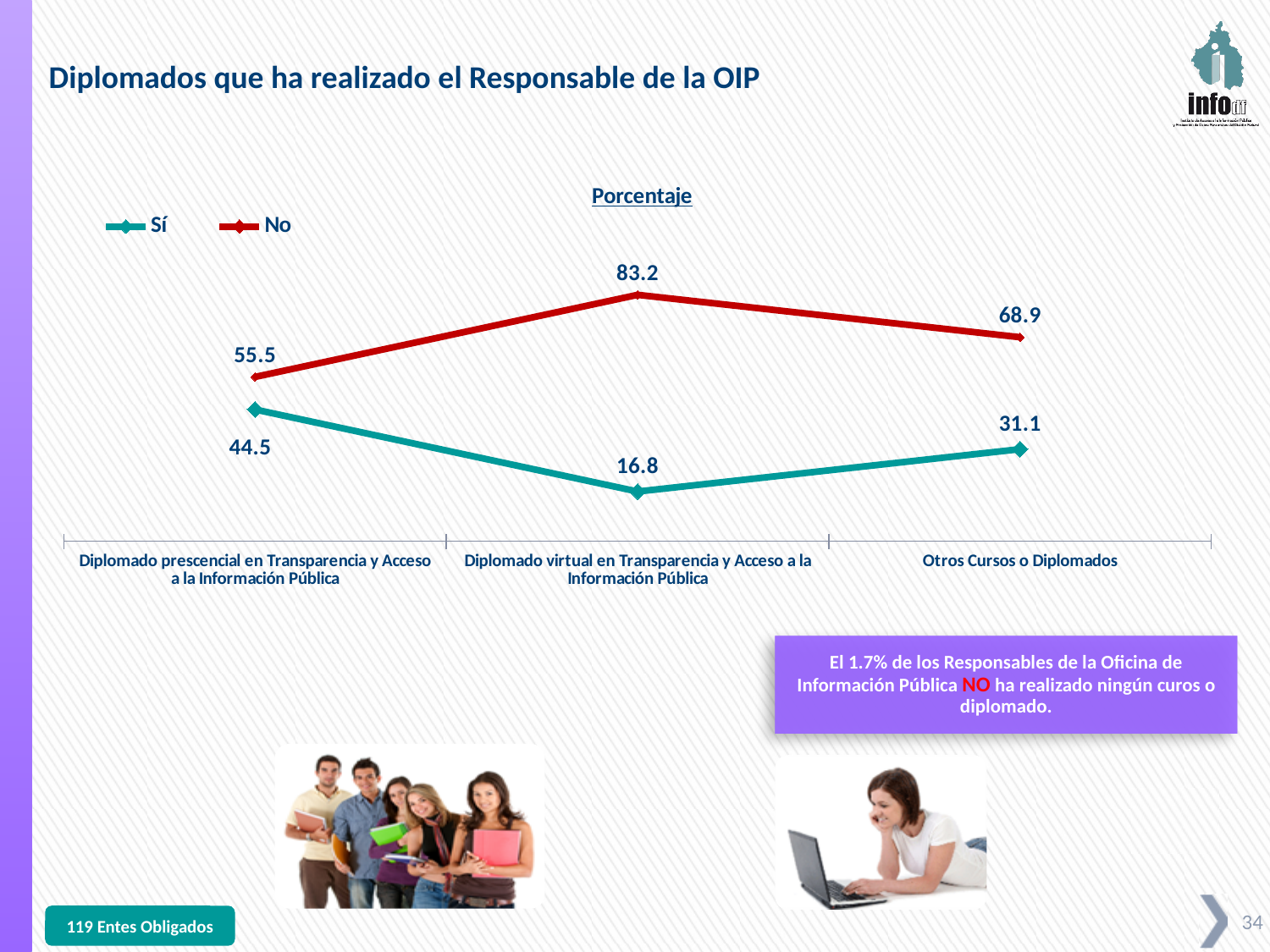
Which category has the lowest 'Sí' value? Diplomado virtual en Transparencia y Acceso a la Información Pública What is the 'Sí' value for 'Diplomado virtual en Transparencia y Acceso a la Información Pública'? 16.8 What kind of chart is shown on the slide? Line chart What is the title shown above the chart? Porcentaje What is the difference between the 'No' and 'Sí' values for 'Otros Cursos o Diplomados'? 37.8 Which category has the highest 'No' value? Diplomado virtual en Transparencia y Acceso a la Información Pública What colour is the 'Sí' line? Teal What is the 'No' value for 'Otros Cursos o Diplomados'? 68.9 How many categories are shown on the x axis? 3 Which is larger for 'Diplomado prescencial en Transparencia y Acceso a la Información Pública': the 'Sí' value or the 'No' value? No What is the 'No' value for 'Diplomado prescencial en Transparencia y Acceso a la Información Pública'? 55.5 How many series does the legend list? 2